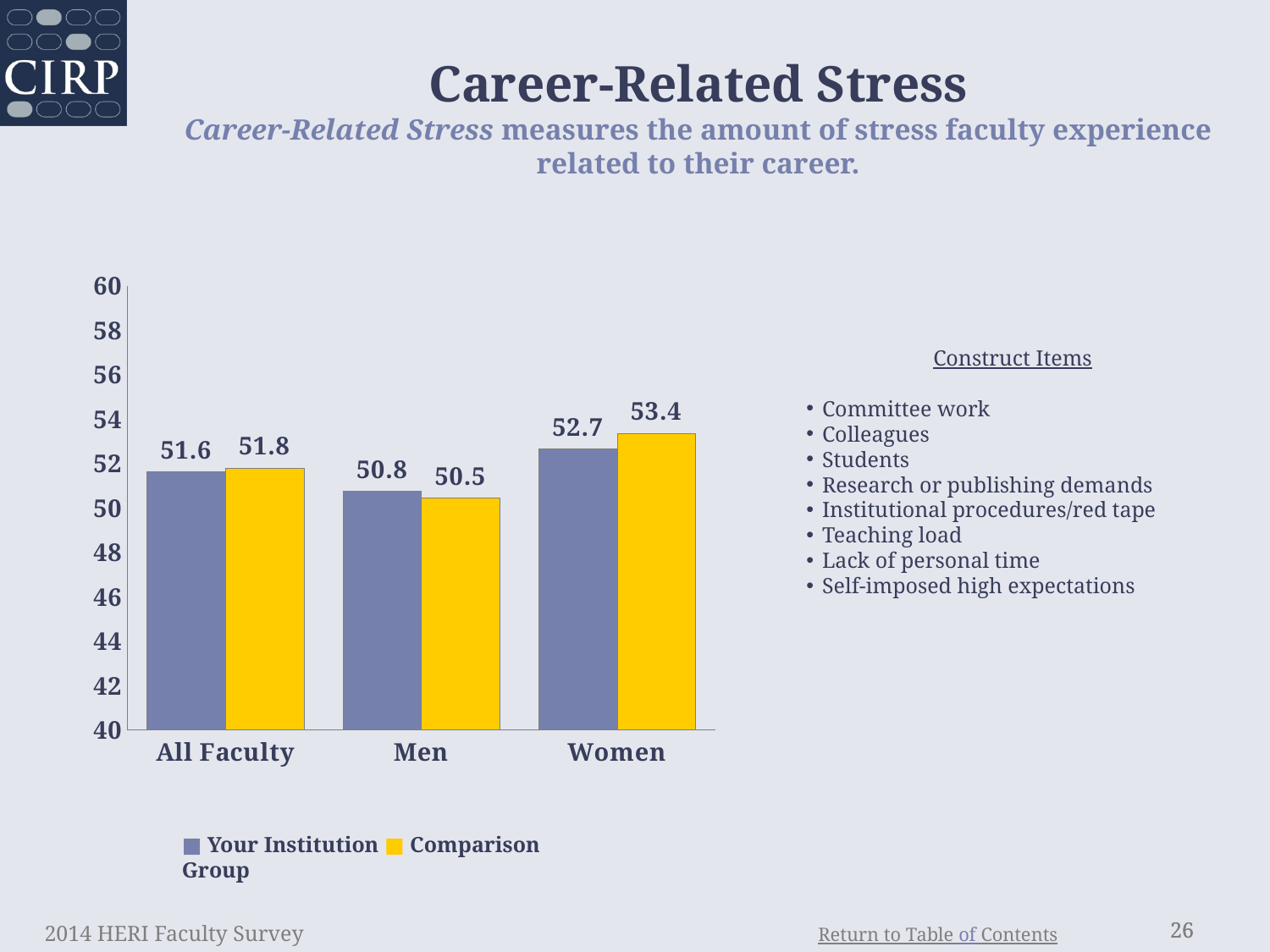
How many categories are shown on the x axis? 3 What is the difference between the Comparison Group and Your Institution values for Women? 0.7 Which category has the highest Comparison Group value? Women How many series does the legend list? 2 What is the Your Institution value for All Faculty? 51.6 What kind of chart is shown on the slide? bar chart What is the Your Institution value for Women? 52.7 Which category has the lowest Your Institution value? Men Is the Comparison Group value for Women greater or less than 52? greater For Men, which is larger: Your Institution or Comparison Group? Your Institution What is the Comparison Group value for Men? 50.5 What colour represents the Comparison Group series? yellow